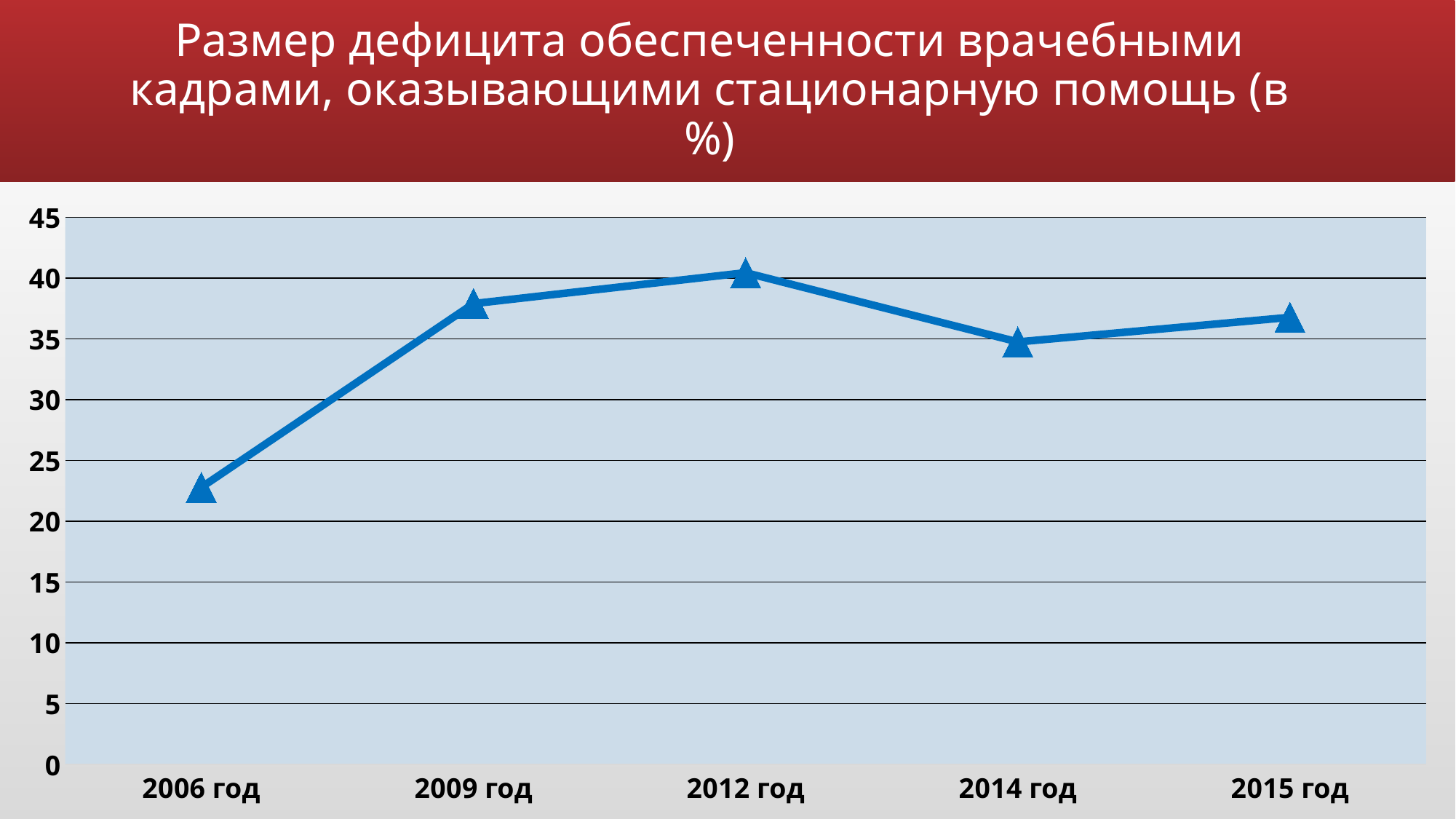
Which year has the highest value on the chart? 2012 год Is the value for 2009 год greater or less than 35? greater Does the value rise or fall from 2006 год to 2012 год? rise Is the value for 2012 год greater or less than 35? greater Is the value for 2006 год greater or less than 25? less Which is larger, the value for 2009 год or the value for 2006 год? 2009 год Which year has the lowest value on the chart? 2006 год How many years (data points) are plotted on the chart? 5 What kind of chart is shown on the slide? line chart What is the title of the chart on the slide? Размер дефицита обеспеченности врачебными кадрами, оказывающими стационарную помощь (в %)